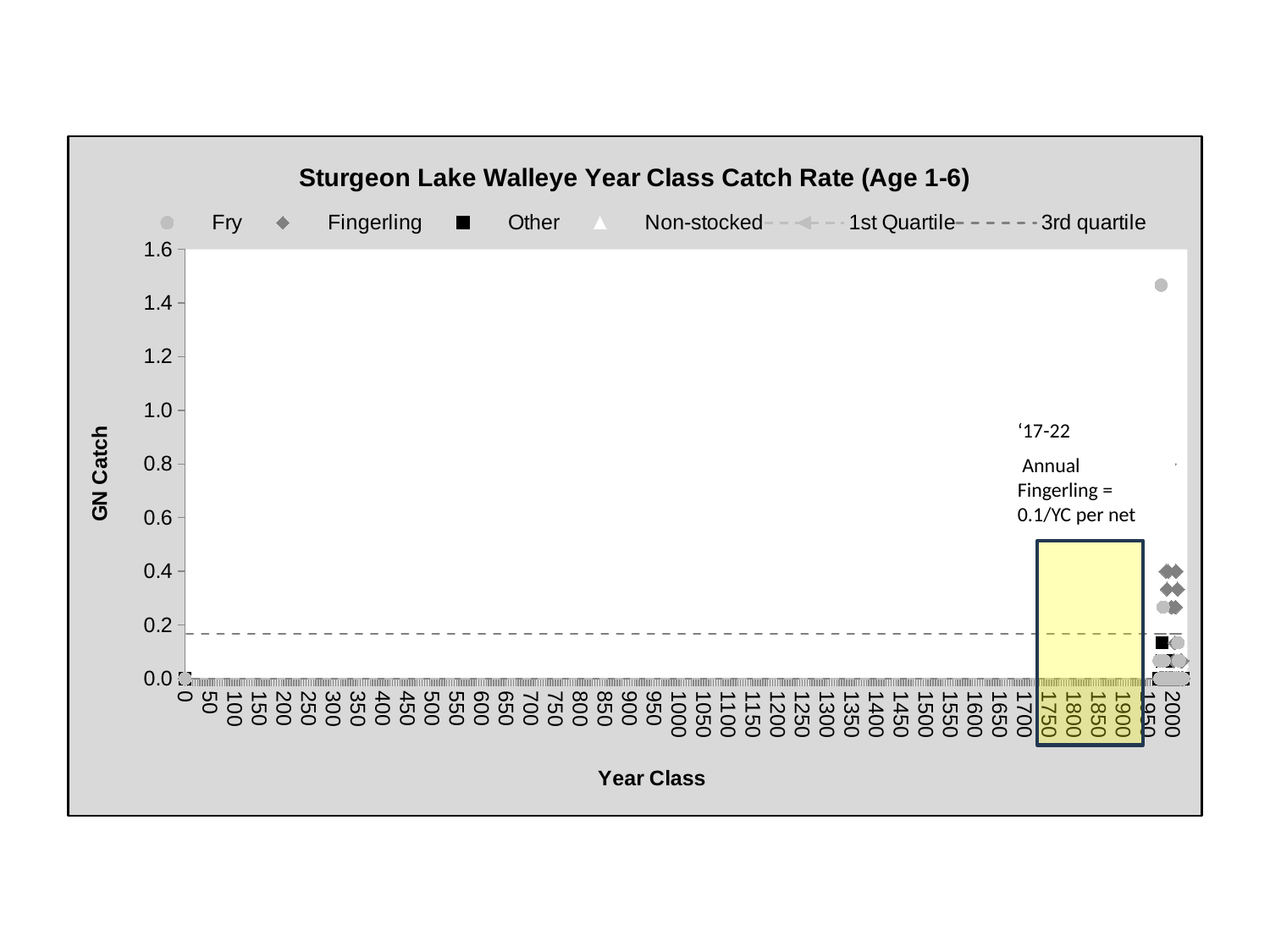
Is the 3rd quartile dashed line on the chart greater or less than 0.2 on the GN Catch axis? less What kind of chart is shown on the slide? scatter chart Is the highest Fry point on the chart greater or less than 1.2 on the GN Catch axis? greater How many entries does the chart legend list? 6 What is the title of the chart? Sturgeon Lake Walleye Year Class Catch Rate (Age 1-6) According to the annotation on the chart, what is the annual fingerling catch rate for '17-22? 0.1/YC per net What is the label on the vertical axis of the chart? GN Catch Which series has the highest plotted point on the chart? Fry Is the highest Fry point on the chart greater or less than 1.4 on the GN Catch axis? greater